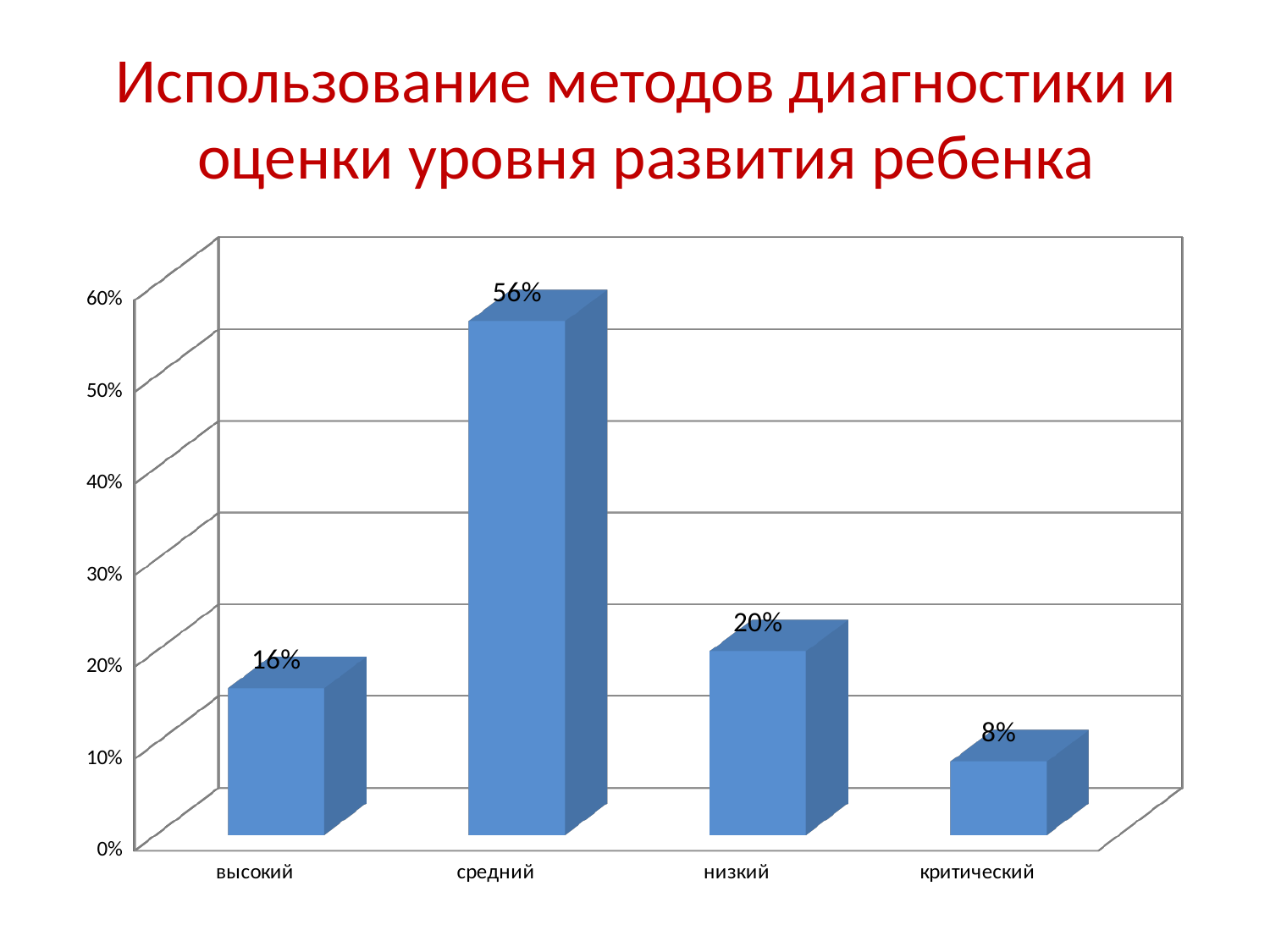
Is the value for 'средний' greater or less than 50%? greater How many categories are shown on the x axis? 4 What is the title of the slide? Использование методов диагностики и оценки уровня развития ребенка Which category has the highest value? средний Which is larger, the value for 'низкий' or the value for 'высокий'? низкий Which category has the lowest value? критический What is the value for the category 'высокий'? 16% What is the value for the category 'низкий'? 20% What kind of chart is shown on the slide? bar chart What is the difference between the values for 'средний' and 'низкий'? 36% What is the value for the category 'средний'? 56% What is the value for the category 'критический'? 8%